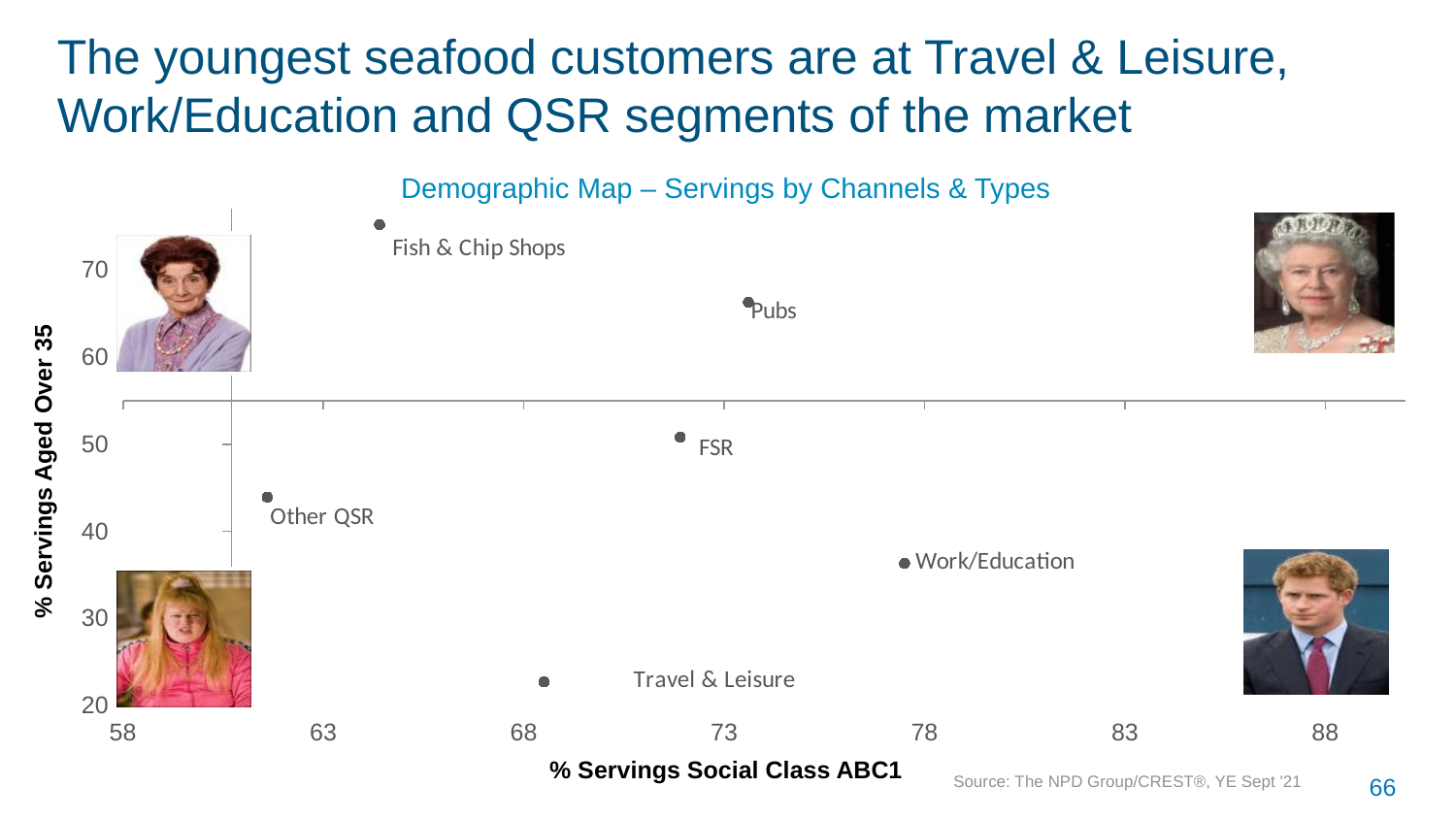
Which has a higher % Servings Aged Over 35, Pubs or FSR? Pubs Which channel has the lowest % Servings Aged Over 35? Travel & Leisure What kind of chart is shown on the slide? Scatter chart Which channel has the lowest % Servings Social Class ABC1? Other QSR Which channel has the highest % Servings Aged Over 35? Fish & Chip Shops Which channel has the highest % Servings Social Class ABC1? Work/Education What is the title of the chart? Demographic Map – Servings by Channels & Types Is the % Servings Aged Over 35 for Fish & Chip Shops greater or less than 70? greater Is the % Servings Aged Over 35 for Travel & Leisure greater or less than 30? less What is the label of the horizontal axis? % Servings Social Class ABC1 Is the % Servings Social Class ABC1 for Work/Education greater or less than 73? greater How many labelled data points are plotted on the chart? 6